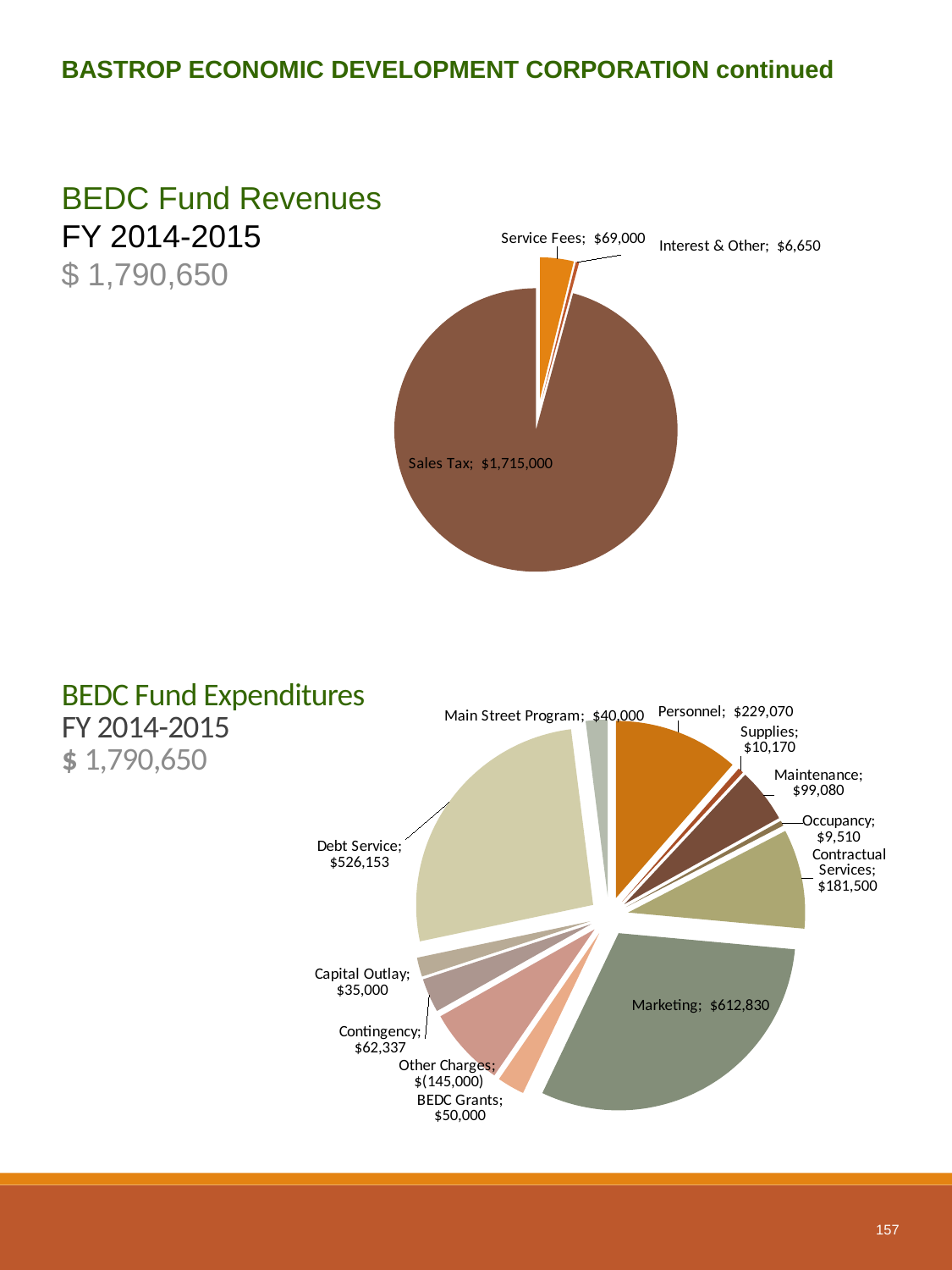
On the BEDC Fund Revenues chart, what is the difference between Service Fees and Interest & Other? $62,350 On the BEDC Fund Revenues chart, which category is the smallest? Interest & Other On the BEDC Fund Revenues chart, what is the value for Sales Tax? $1,715,000 How many categories does the BEDC Fund Expenditures pie chart show? 12 On the BEDC Fund Expenditures chart, what is the value for Marketing? $612,830 On the BEDC Fund Expenditures chart, which category has the largest value? Marketing How many categories does the BEDC Fund Revenues pie chart show? 3 On the BEDC Fund Expenditures chart, which is larger, Personnel or Contractual Services? Personnel On the BEDC Fund Expenditures chart, what is the difference between Marketing and Debt Service? $86,677 On the BEDC Fund Expenditures chart, what is the value for Other Charges? $(145,000) On the BEDC Fund Revenues chart, what is the value for Interest & Other? $6,650 What kind of chart is the BEDC Fund Expenditures chart? Pie chart